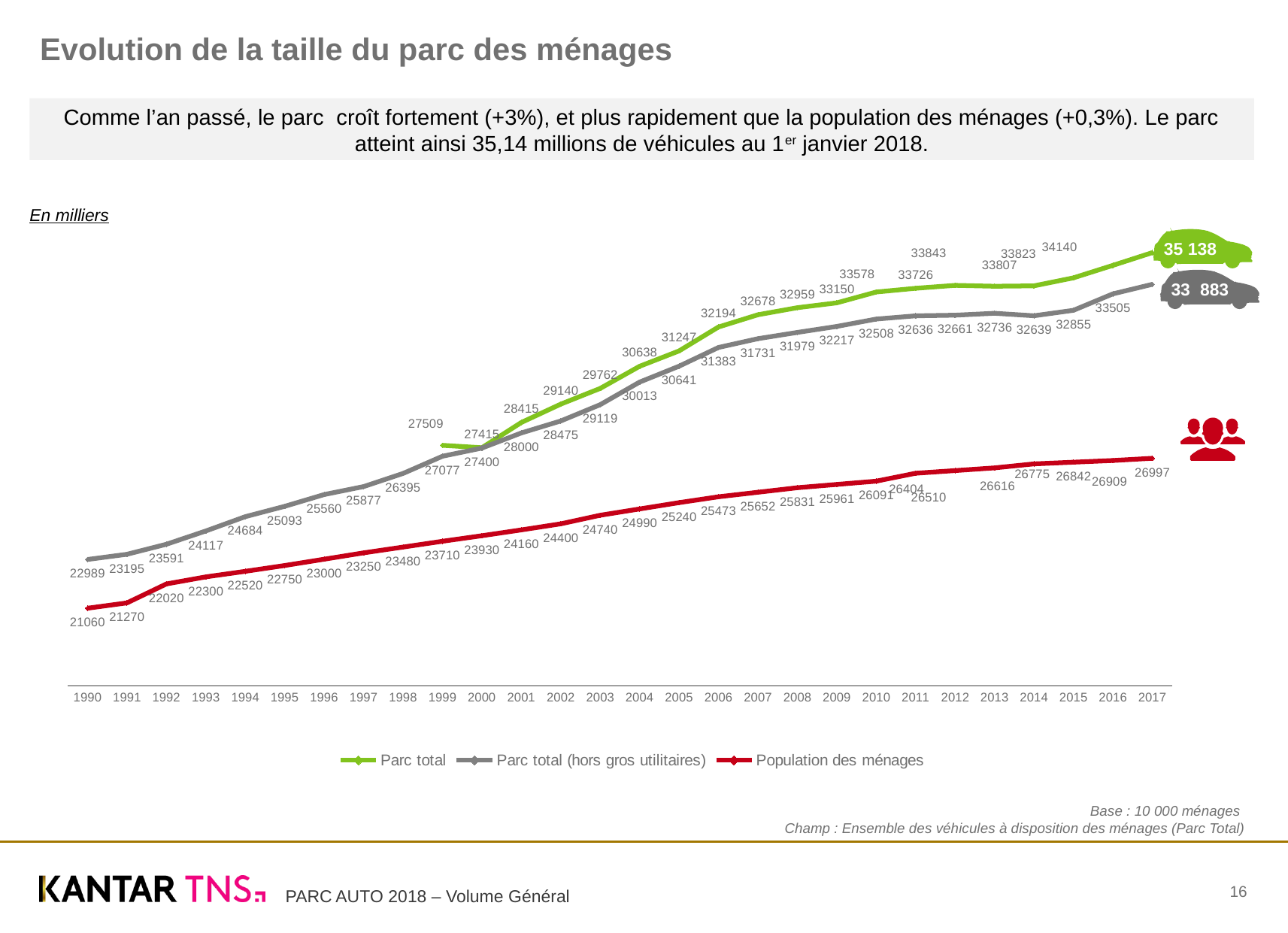
What is the value of Population des ménages in 1990? 21060 How many years are shown on the x axis? 28 Which is larger in 2010: Parc total or Parc total (hors gros utilitaires)? Parc total What kind of chart is shown on the slide? line chart In which year is Population des ménages highest? 2017 What is the value of Parc total in 2017? 35 138 What is the value of Parc total in 2005? 31247 Does the Population des ménages series rise or fall from 1990 to 2017? rise What is the difference between Parc total and Parc total (hors gros utilitaires) in 2017? 1255 What is the value of Parc total (hors gros utilitaires) in 2017? 33 883 How many series does the legend list? 3 In which year is Parc total (hors gros utilitaires) lowest? 1990